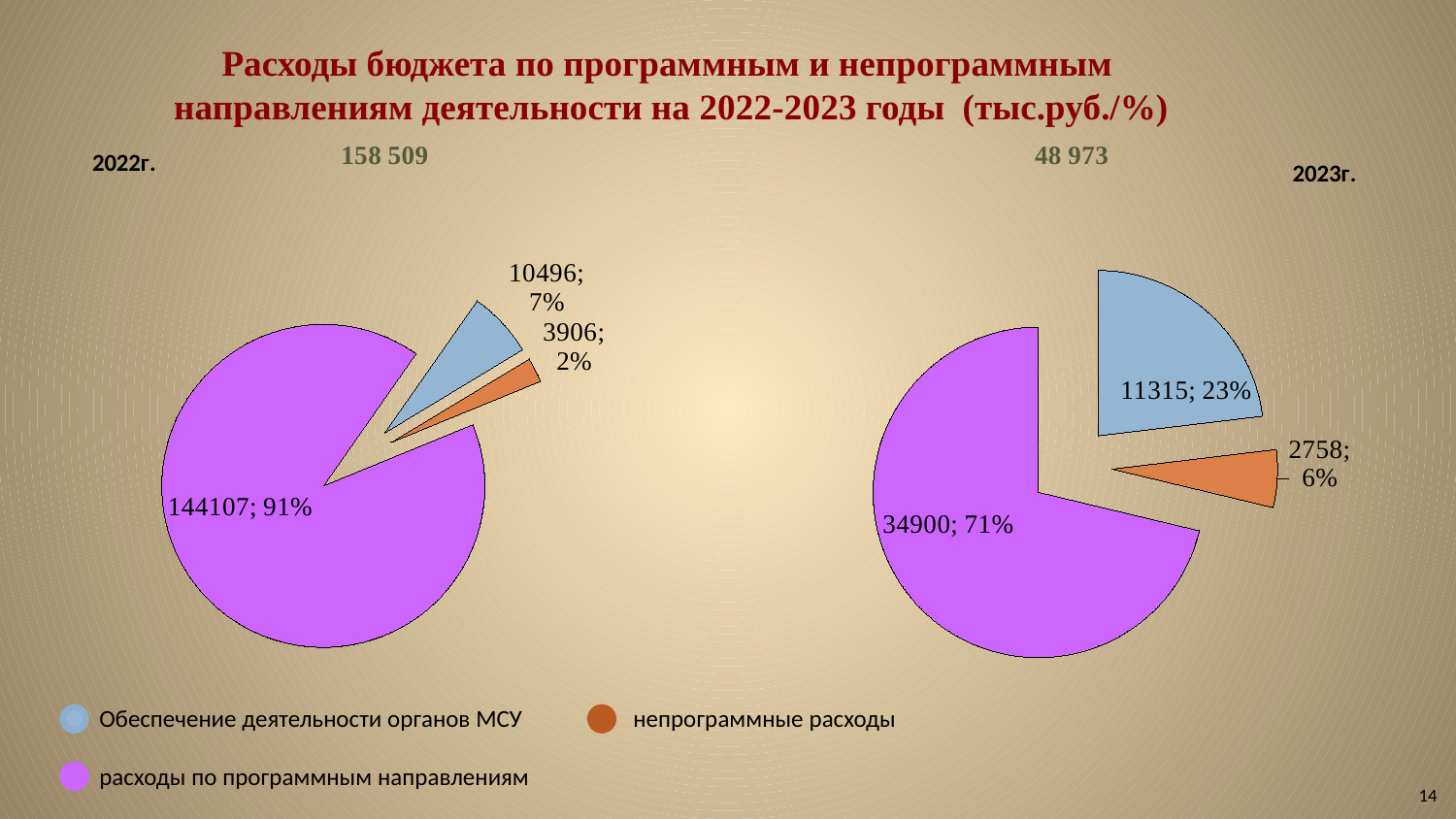
In the 2022 pie chart, what is the value for непрограммные расходы? 3906; 2% In the 2023 pie chart, what is the difference between расходы по программным направлениям and Обеспечение деятельности органов МСУ? 23585 What colour represents непрограммные расходы in the legend? orange In the 2023 pie chart, which category has the smallest slice? непрограммные расходы What type of chart is used for the 2023 data? pie chart In the 2023 pie chart, what share does непрограммные расходы have? 6% Which is larger: Обеспечение деятельности органов МСУ in 2022 or in 2023? 2023 How many slices does the 2022 pie chart have? 3 In the 2022 pie chart, what is the value for расходы по программным направлениям? 144107; 91% In the 2022 pie chart, which category has the largest slice? расходы по программным направлениям What total is shown above the 2022 pie chart? 158 509 In the 2023 pie chart, what is the value for Обеспечение деятельности органов МСУ? 11315; 23%